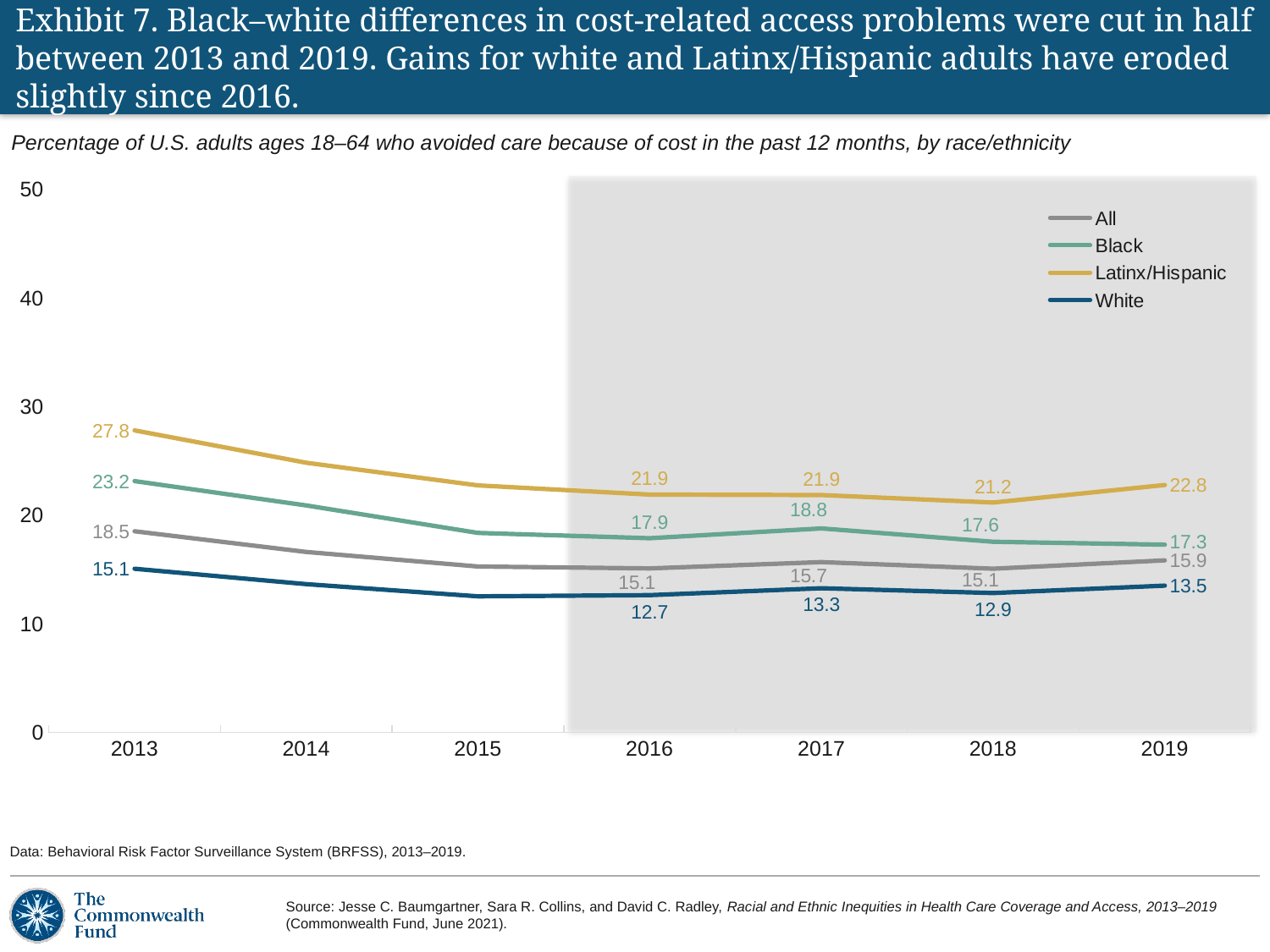
What kind of chart is shown on the slide? Line chart What was the value for White adults in 2019? 13.5 Is the value for Latinx/Hispanic adults in 2015 greater or less than 20? greater What was the value for the All series in 2017? 15.7 What is the difference between the Black and White values in 2019? 3.8 What was the percentage of Black adults who avoided care because of cost in 2013? 23.2 What is the difference between the Black and White values in 2013? 8.1 Which group had the highest percentage in 2013? Latinx/Hispanic Which group had the lowest percentage in 2016? White What was the value for Latinx/Hispanic adults in 2018? 21.2 How many series does the legend list? 4 Was the Latinx/Hispanic value higher in 2019 or in 2018? 2019